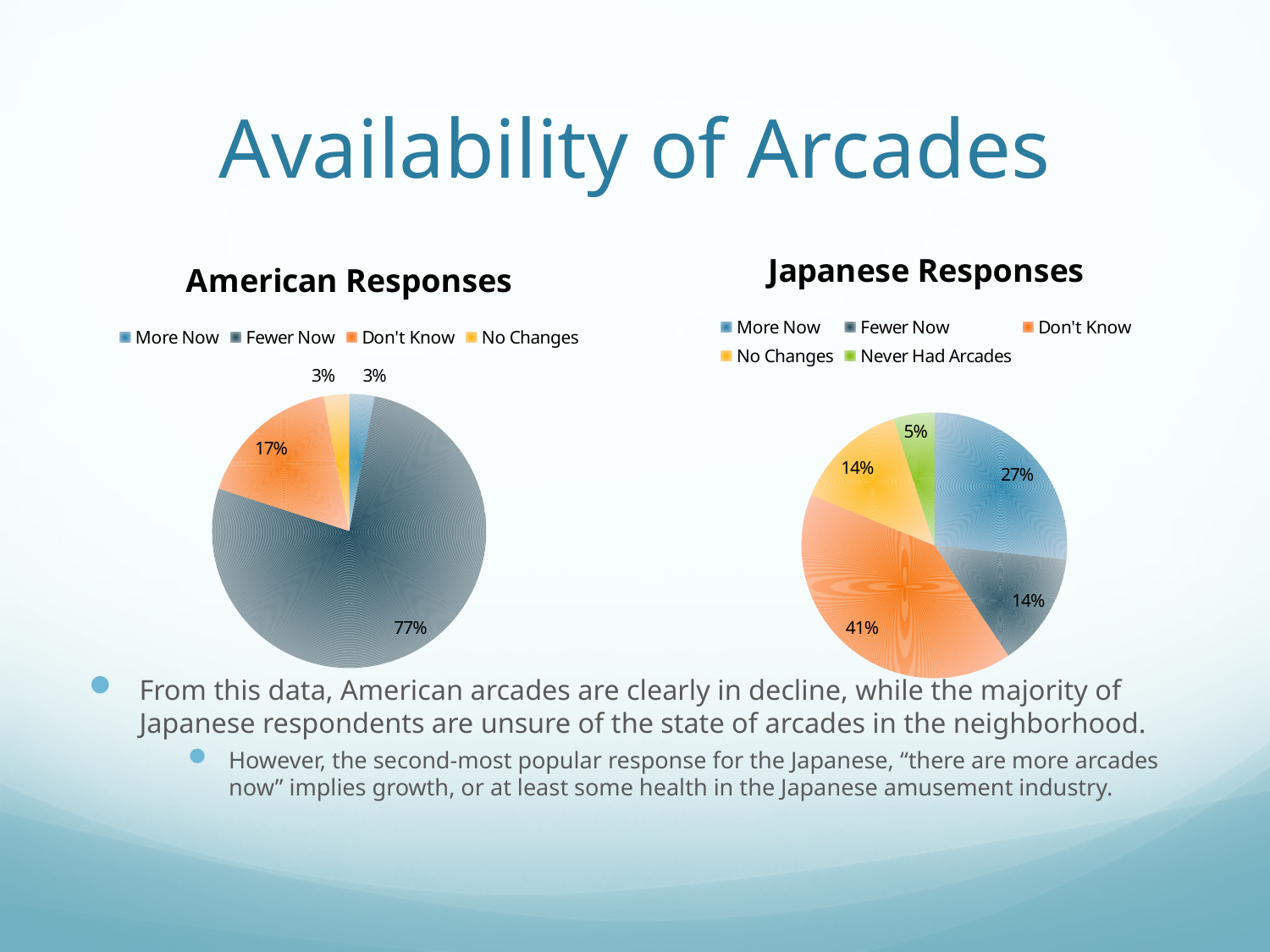
In the American Responses chart, what share of respondents answered "Fewer Now"? 77% In the American Responses chart, which response has the largest share? Fewer Now In the Japanese Responses chart, what is the difference in percentage points between "Don't Know" and "More Now"? 14 percentage points In the American Responses chart, what colour is the "Don't Know" slice? Orange Which is larger: the "Fewer Now" share in the American Responses chart or the "Fewer Now" share in the Japanese Responses chart? American Responses What type of chart is the American Responses chart? Pie chart In the Japanese Responses chart, what share of respondents answered "Don't Know"? 41% In the Japanese Responses chart, what share of respondents answered "Never Had Arcades"? 5% In the American Responses chart, what share of respondents answered "Don't Know"? 17% In the Japanese Responses chart, what share of respondents answered "More Now"? 27% How many response categories does the legend of the Japanese Responses chart list? 5 In the Japanese Responses chart, which response has the smallest share? Never Had Arcades